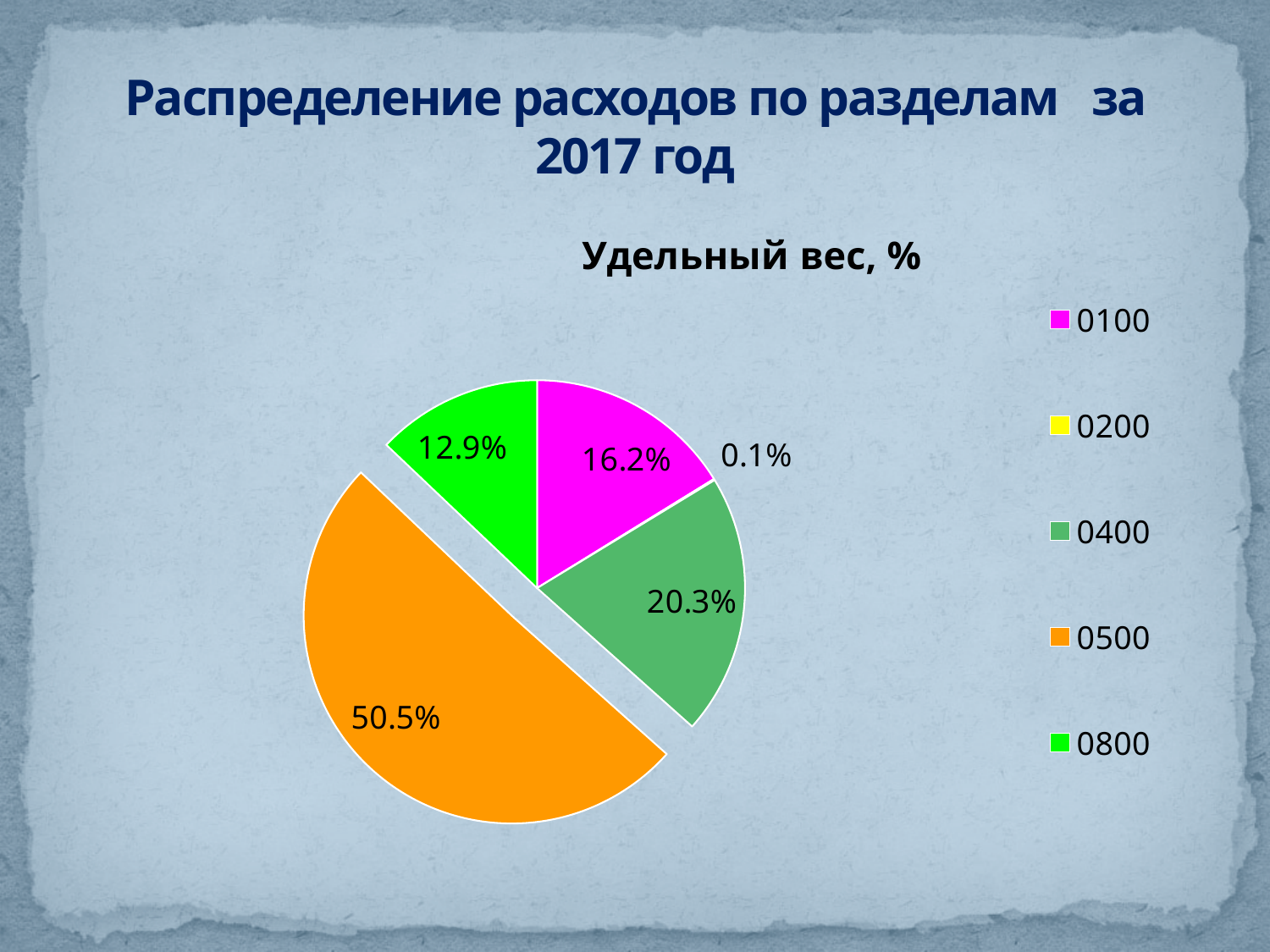
What is the share for category 0200? 0.1% Which category has the largest share of the pie? 0500 Which has a larger share, 0100 or 0800? 0100 What is the difference between the shares of 0500 and 0400? 30.2% How many categories does the legend list? 5 Which category has the smallest share of the pie? 0200 What type of chart is shown on the slide? pie chart What is the share for category 0800? 12.9% What is the share for category 0500? 50.5% What is the title of the chart? Удельный вес, % What is the share for category 0100? 16.2% What is the share for category 0400? 20.3%